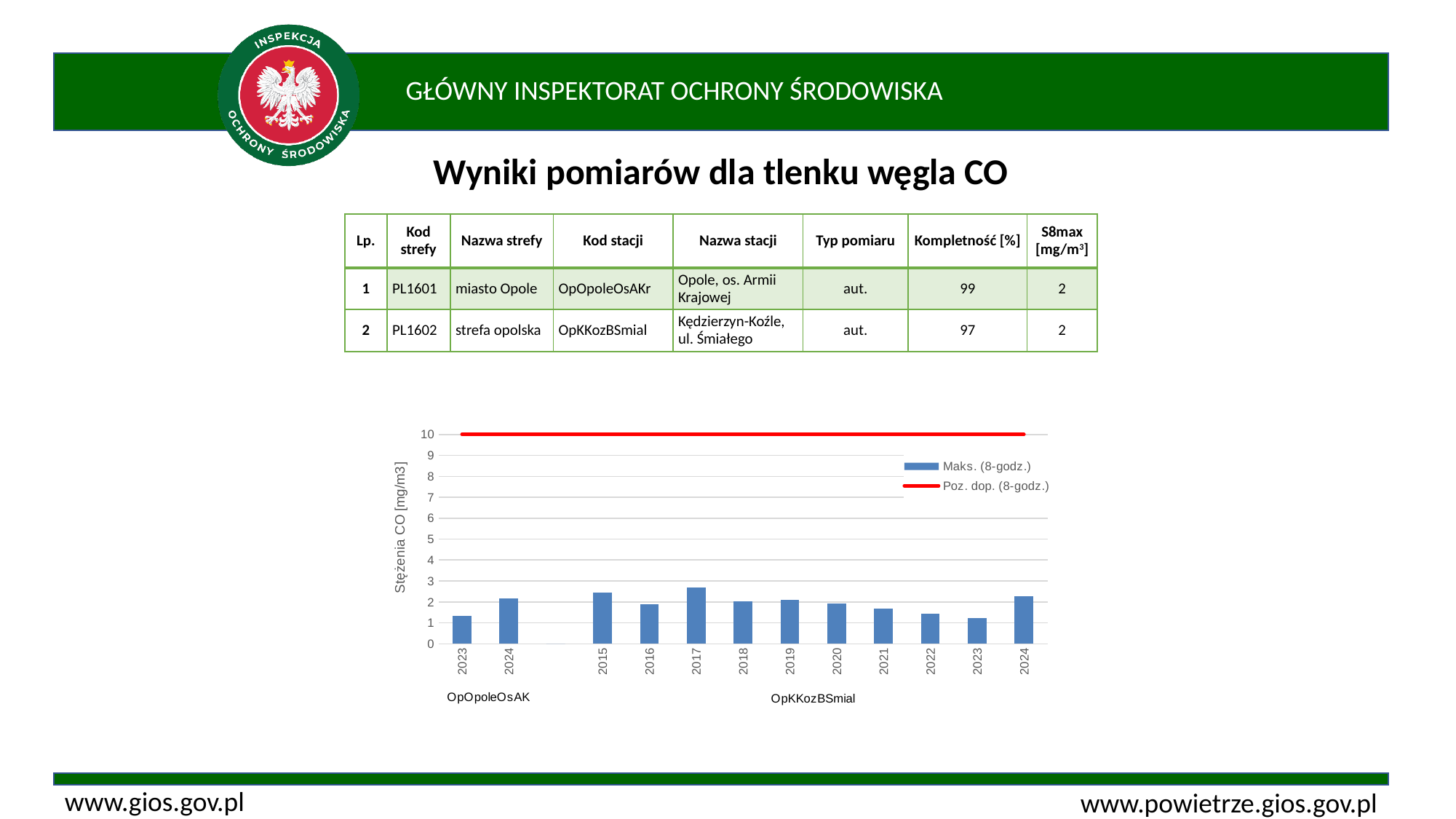
What are the two entries in the chart legend? Maks. (8-godz.) and Poz. dop. (8-godz.) What is the label of the y axis of the chart? Stężenia CO [mg/m3] How many bars are plotted in the chart? 12 At what level does the red 'Poz. dop. (8-godz.)' line sit on the y axis? 10 For station OpKKozBSmial, do the values rise or fall from 2017 to 2023? fall How many series does the chart legend list? 2 For station OpKKozBSmial, which is larger: the value for 2017 or the value for 2022? 2017 Is the value for OpKKozBSmial in 2017 greater or less than 2? greater What kind of chart is shown on the slide? combination bar and line chart Is the value for OpKKozBSmial in 2023 greater or less than 2? less Is the value for OpOpoleOsAK in 2023 greater or less than 2? less Which year has the highest bar for station OpKKozBSmial? 2017